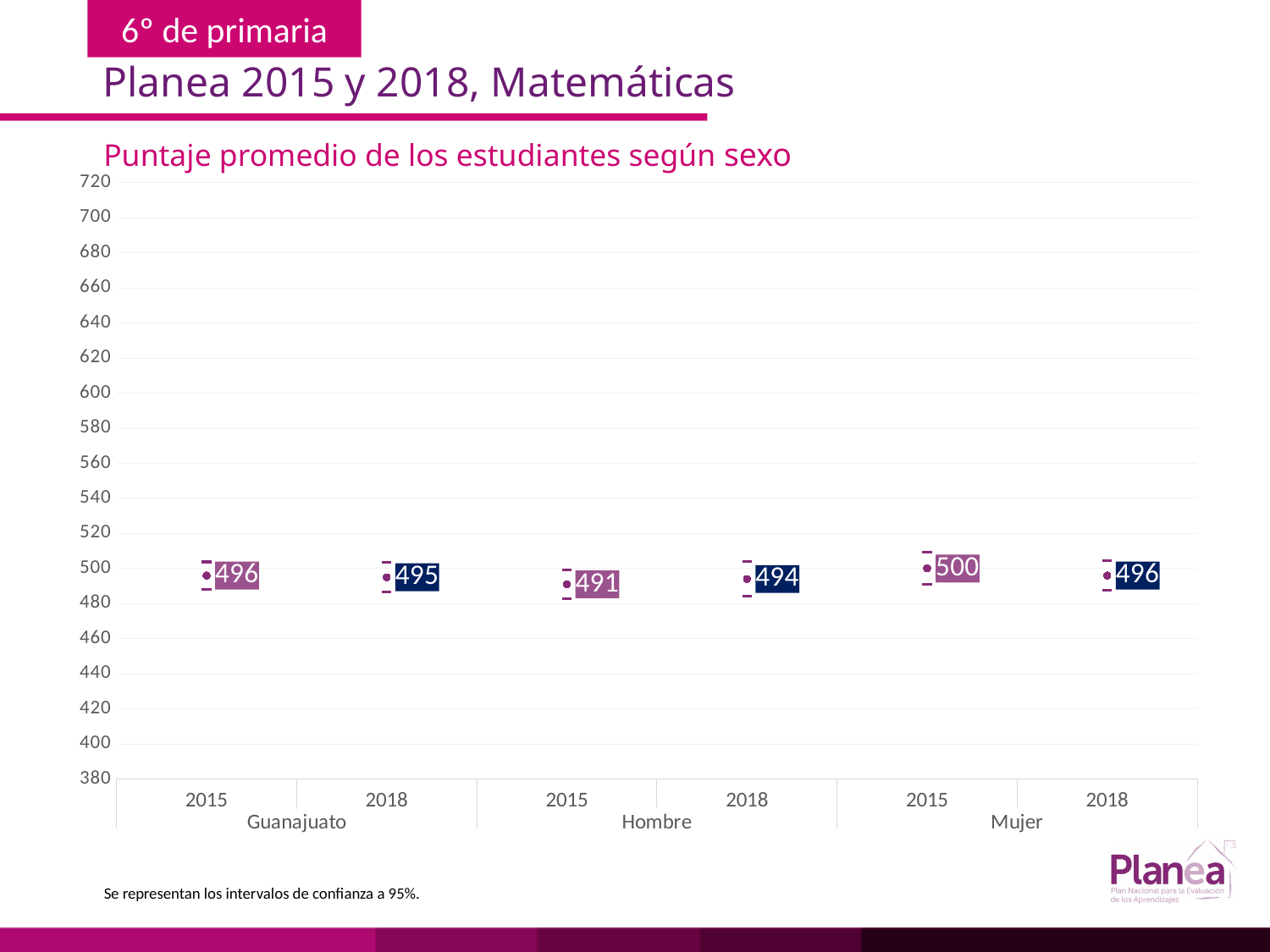
By how much did the Hombre score change from 2015 to 2018? 3 What is the average score for Hombre in 2018? 494 Which group and year has the lowest average score? Hombre 2015 What is the average score for Guanajuato in 2015? 496 What is the average score for Mujer in 2015? 500 Which group and year has the highest average score? Mujer 2015 How many data points are plotted on the chart? 6 What is the title of the chart? Puntaje promedio de los estudiantes según sexo What is the difference between the Mujer 2015 score and the Hombre 2015 score? 9 Which is larger, the Mujer 2018 score or the Hombre 2018 score? Mujer 2018 Did the Guanajuato average score rise or fall from 2015 to 2018? Fall What is the average score for Mujer in 2018? 496